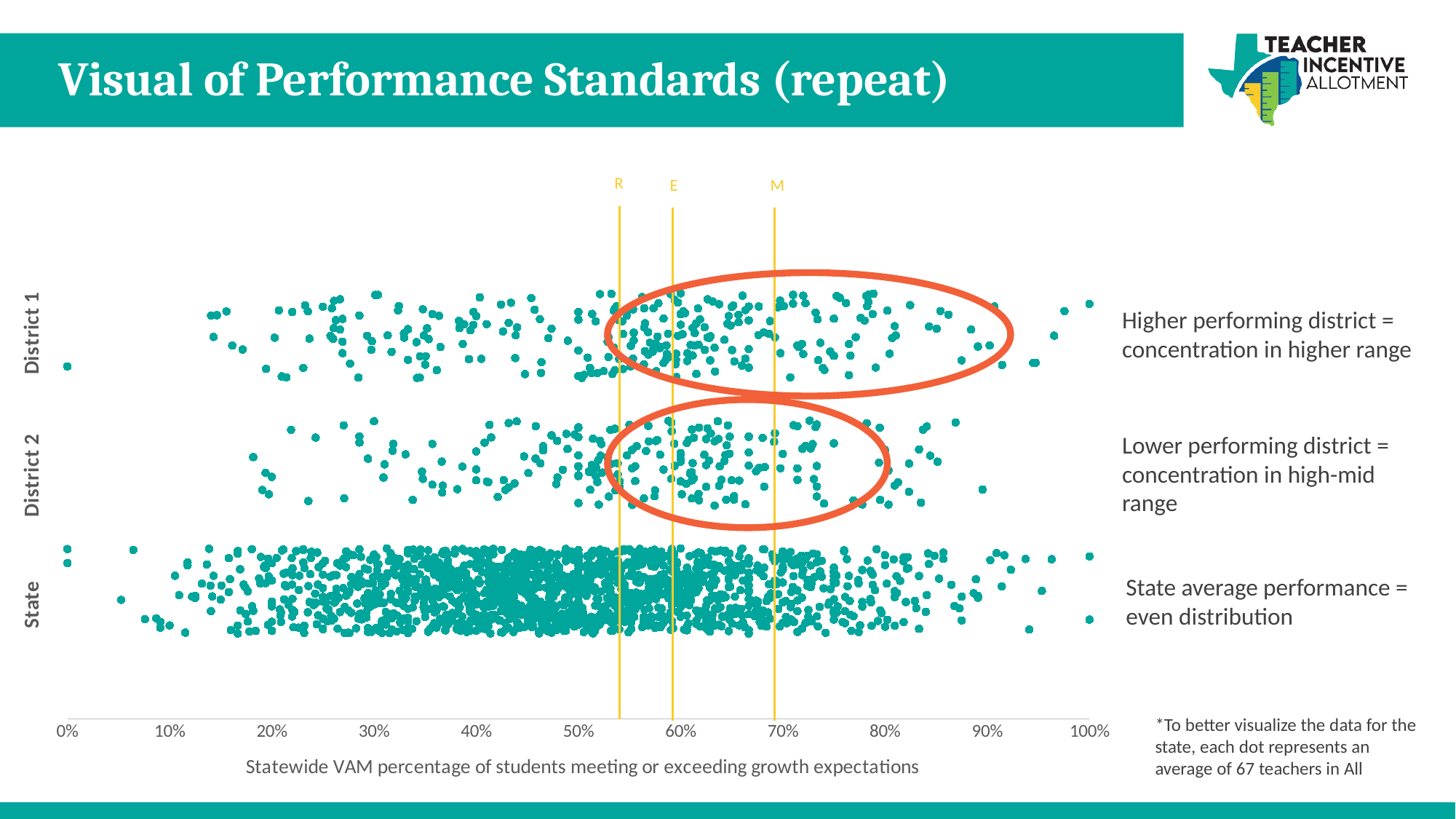
How many categories are plotted on the vertical axis of the chart? 3 Is the vertical line labeled M positioned at a value greater or less than 60%? greater Is the vertical line labeled R positioned at a value greater or less than 60%? less Which category's dots are described on the slide as showing a concentration in the higher range? District 1 According to the footnote, how many teachers does each dot in the State row represent on average? 67 What are the labels of the three vertical lines drawn on the chart, from left to right? R, E, M What is the highest tick value shown on the horizontal axis? 100% What are the three categories plotted on the chart, from top to bottom? District 1, District 2, State What is the label of the horizontal axis of the chart? Statewide VAM percentage of students meeting or exceeding growth expectations What kind of chart is shown on the slide? Dot plot (scatter plot) Which category is described on the slide as having an even distribution? State